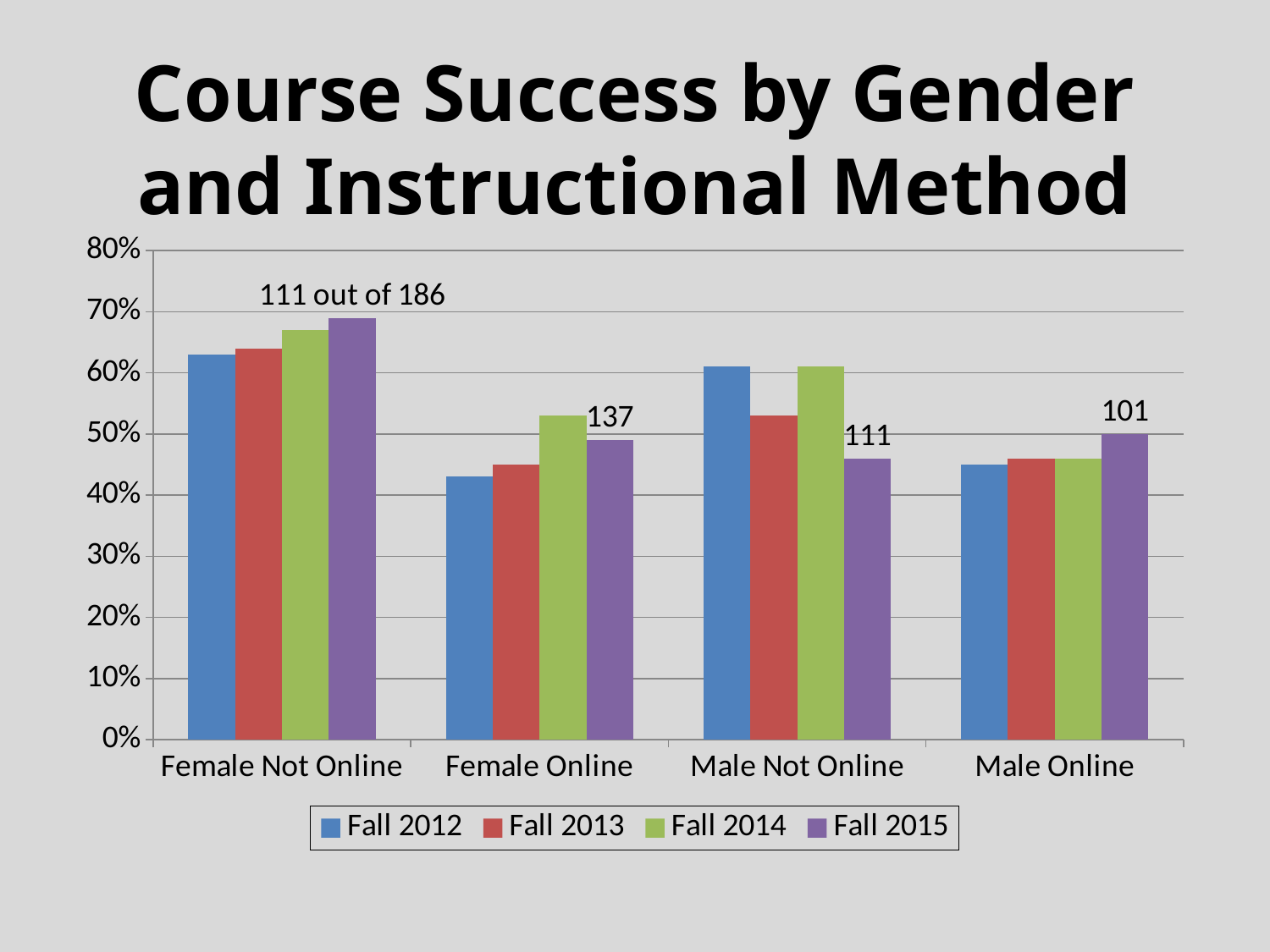
What text annotation appears above the Female Not Online bars? 111 out of 186 What kind of chart is shown on the slide? bar chart For Male Not Online, which is larger: the Fall 2013 value or the Fall 2015 value? Fall 2013 Within the Female Online category, which series has the highest value? Fall 2014 Which category has the highest Fall 2015 value? Female Not Online For Female Online, which is larger: the Fall 2014 value or the Fall 2012 value? Fall 2014 Is the Fall 2015 value for Female Not Online greater or less than 60%? greater How many series does the legend list? 4 Is the Fall 2015 value for Male Not Online greater or less than 50%? less Is the Fall 2012 value for Female Online greater or less than 50%? less Do the Female Not Online values rise or fall from Fall 2012 to Fall 2015? rise How many categories are shown on the x axis? 4